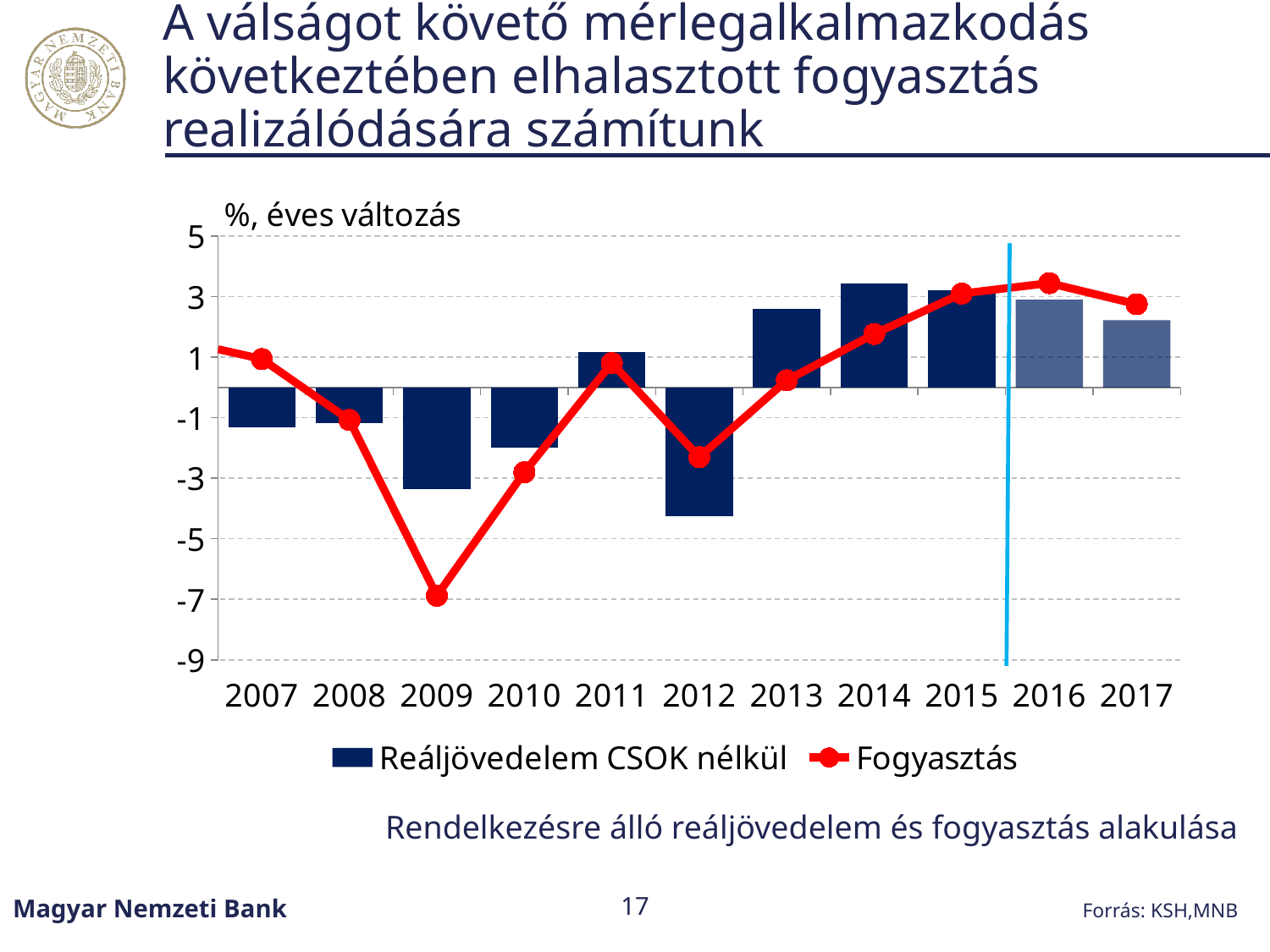
Is the Fogyasztás value for 2009 greater or less than -5? less Is the Reáljövedelem CSOK nélkül value for 2012 greater or less than -3? less In which year does the Fogyasztás line reach its lowest value? 2009 Is the Fogyasztás value for 2016 greater or less than 3? greater What kind of chart is shown on the slide? A combined bar and line chart Does the Fogyasztás line rise or fall between 2012 and 2016? rise How many series does the chart legend list? 2 In 2009, which is larger: the Reáljövedelem CSOK nélkül bar or the Fogyasztás line value? Reáljövedelem CSOK nélkül What unit label is shown above the y axis of the chart? %, éves változás In which year is the Reáljövedelem CSOK nélkül bar the lowest? 2012 How many years are shown on the x axis of the chart? 11